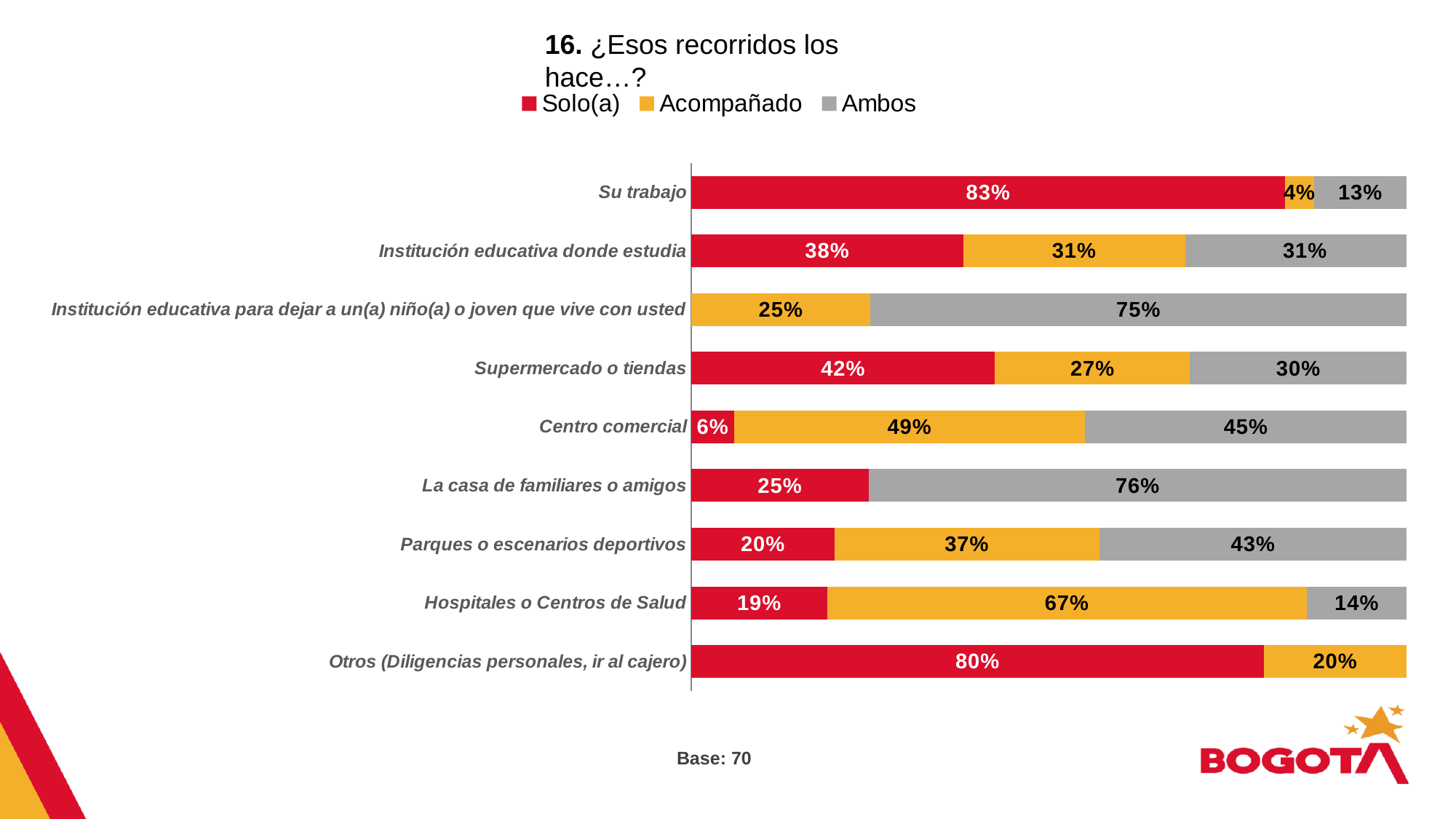
Which category has the highest Acompañado value? Hospitales o Centros de Salud How many categories are shown in the chart? 9 Which category has the highest Solo(a) value? Su trabajo Which category has the lowest labelled Solo(a) value? Centro comercial What is the Acompañado value for Parques o escenarios deportivos? 37% What is the Acompañado value for Hospitales o Centros de Salud? 67% What percentage of respondents go to Su trabajo Solo(a)? 83% What is the difference between the Solo(a) value for Su trabajo and the Solo(a) value for Otros (Diligencias personales, ir al cajero)? 3% What is the Ambos value for Centro comercial? 45% How many series does the legend list? 3 What type of chart is shown on the slide? Stacked bar chart Which is larger: the Ambos value for Supermercado o tiendas or the Ambos value for Institución educativa donde estudia? Institución educativa donde estudia